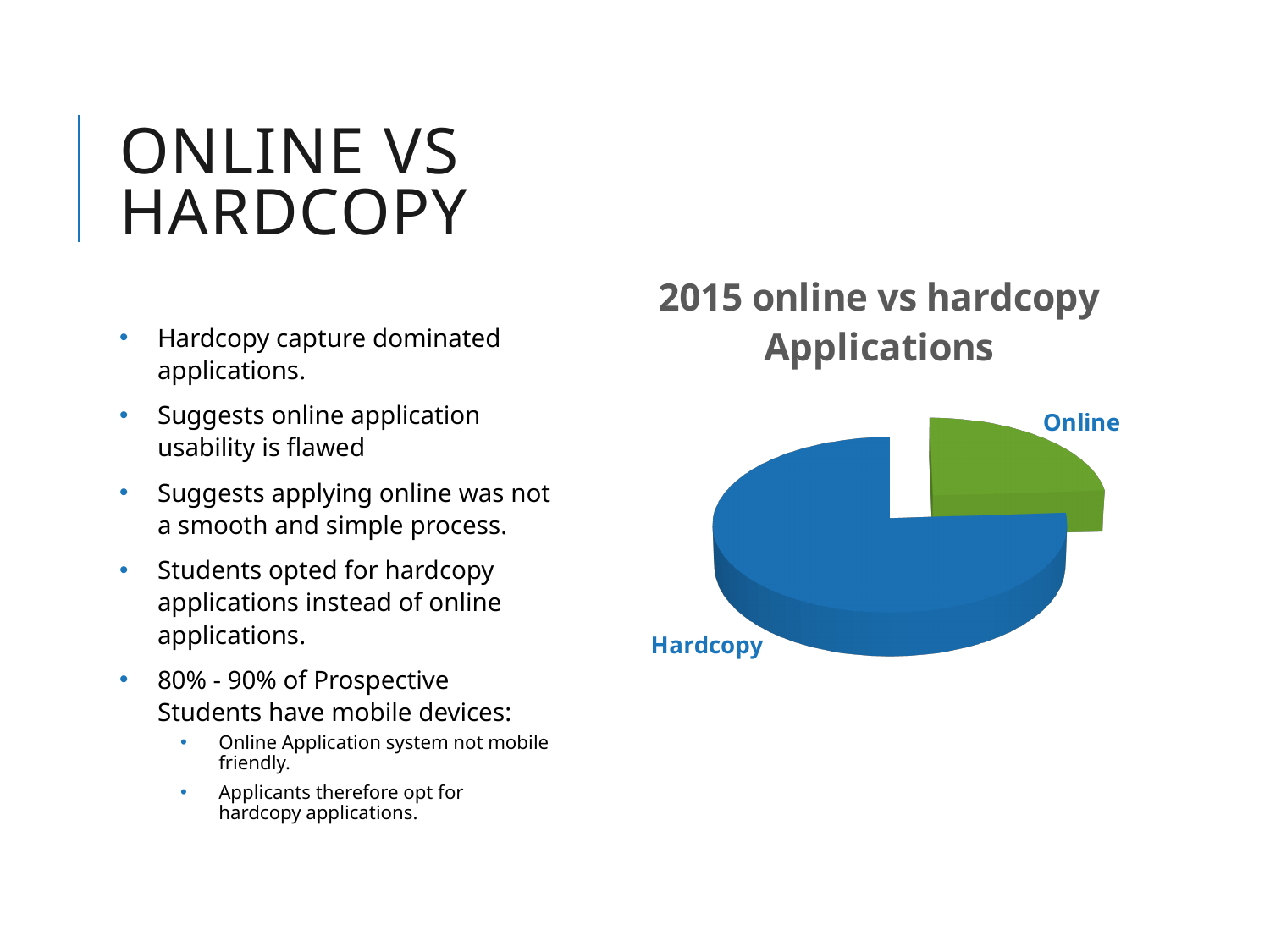
Which slice of the pie chart is the smallest? Online How many slices does the pie chart have? 2 Which slice is shown in green? Online Which slice of the pie chart is the largest? Hardcopy What kind of chart is shown on the slide? pie chart What is the title of the chart? 2015 online vs hardcopy Applications Which is larger in the pie chart, Hardcopy or Online? Hardcopy What colour is the Hardcopy slice? blue